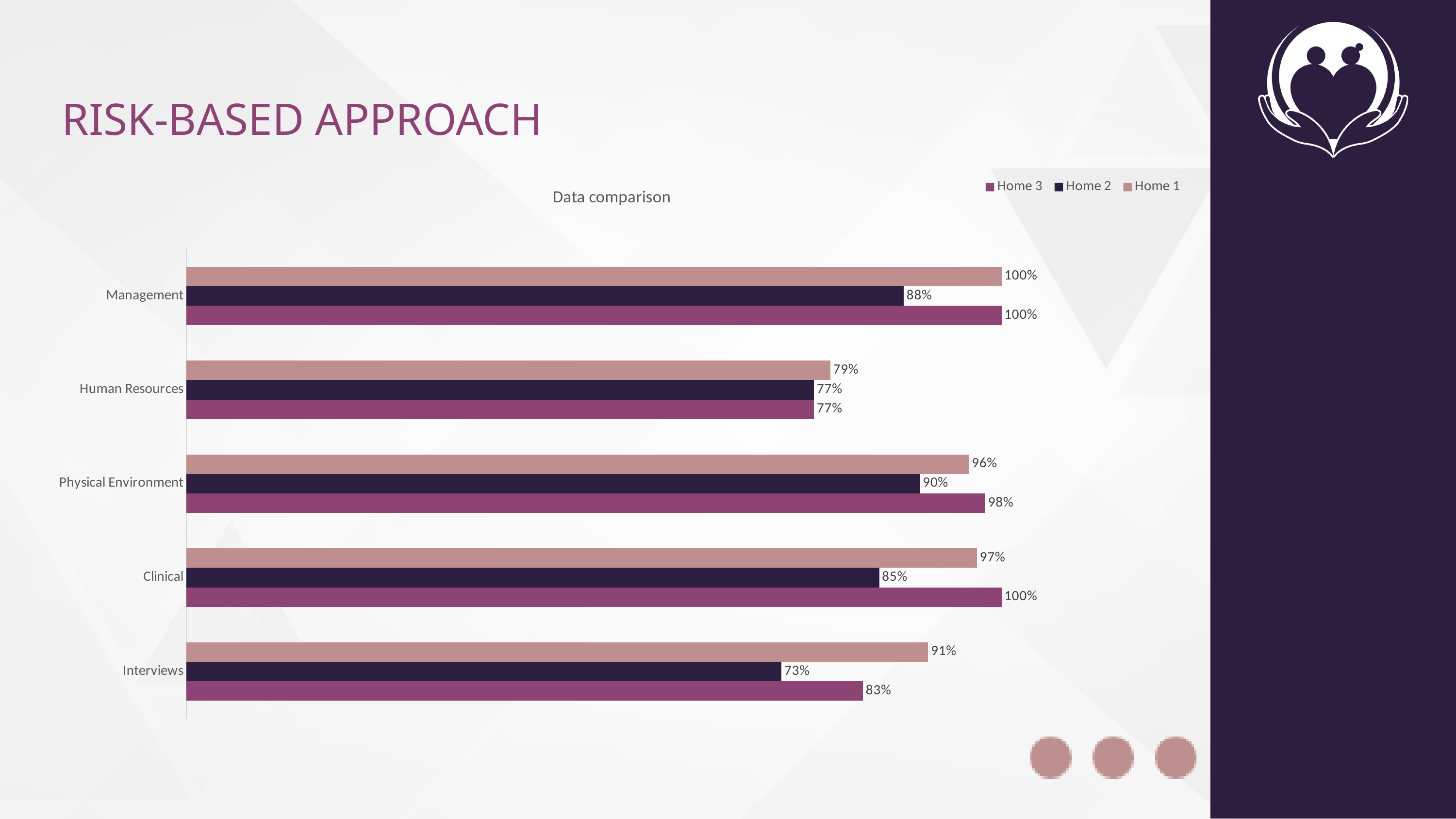
What is the value for Home 2 in the Clinical category? 85% Which category has the lowest value for Home 1? Human Resources How many series does the legend list? 3 What is the value for Home 3 in the Physical Environment category? 98% What is the value for Home 2 in the Management category? 88% What is the difference between Home 1 and Home 2 in the Interviews category? 18% How many categories are shown on the chart? 5 What is the value for Home 1 in the Interviews category? 91% Which is larger in the Physical Environment category, Home 1 or Home 3? Home 3 Which category has the lowest value for Home 2? Interviews What is the difference between Home 3 and Home 2 in the Clinical category? 15% What type of chart is shown on the slide? Bar chart